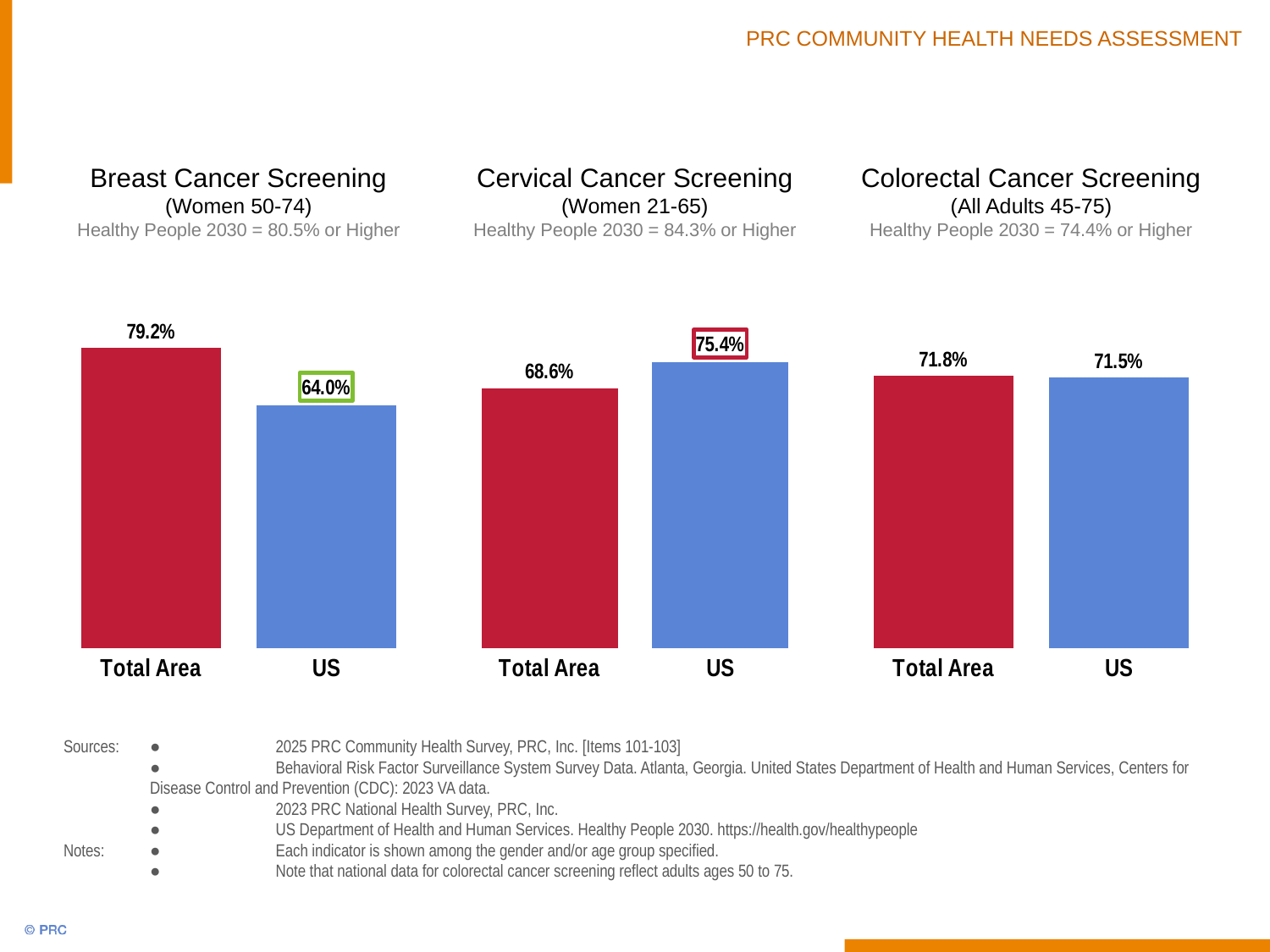
What type of chart is the Cervical Cancer Screening chart? Bar chart How many bars are shown in the Colorectal Cancer Screening chart? 2 In the Breast Cancer Screening chart, what is the difference between the Total Area and US values? 15.2% In the Colorectal Cancer Screening chart, what is the value for Total Area? 71.8% In the Breast Cancer Screening chart, what is the value for Total Area? 79.2% In the Colorectal Cancer Screening chart, what is the value for US? 71.5% In the Breast Cancer Screening chart, what is the value for US? 64.0% In the Cervical Cancer Screening chart, which is larger, Total Area or US? US In the Breast Cancer Screening chart, which category has the highest value? Total Area In the Cervical Cancer Screening chart, what is the value for US? 75.4% In the Cervical Cancer Screening chart, what is the difference between the US and Total Area values? 6.8% In the Cervical Cancer Screening chart, what is the value for Total Area? 68.6%